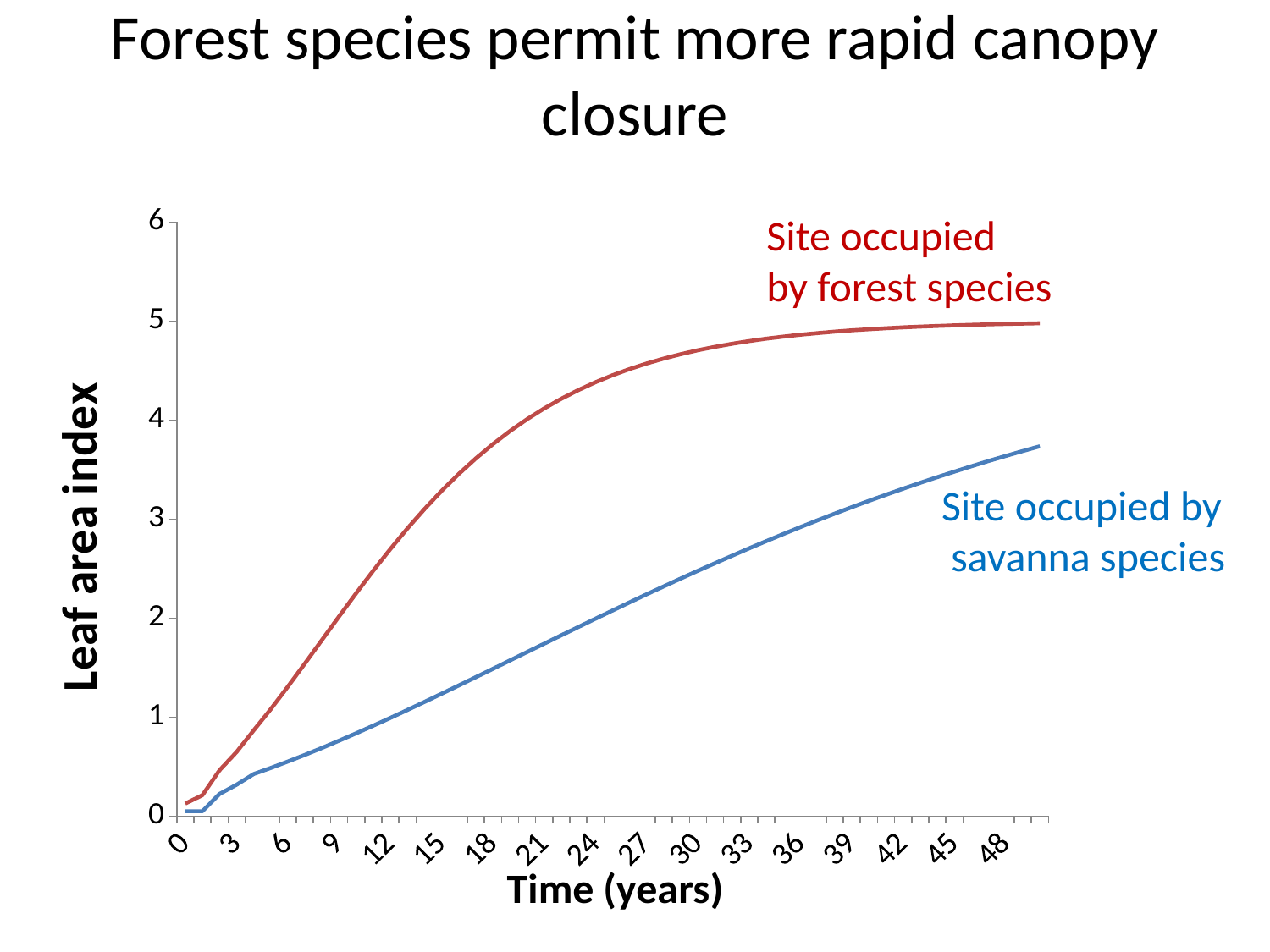
Is the leaf area index for the site occupied by forest species at 12 years greater or less than 2? greater Which series reaches the highest leaf area index on the chart? Site occupied by forest species What kind of chart is shown on the slide? line chart Is the leaf area index for the site occupied by savanna species at 48 years greater or less than 4? less What is the title of the chart on the slide? Forest species permit more rapid canopy closure Is the leaf area index for the site occupied by savanna species at 30 years greater or less than 2? greater What is the label of the y axis? Leaf area index How many series are plotted on the chart? 2 Which series has the higher leaf area index at 30 years: the site occupied by forest species or the site occupied by savanna species? Site occupied by forest species Does the leaf area index for the site occupied by savanna species rise or fall over time? rise